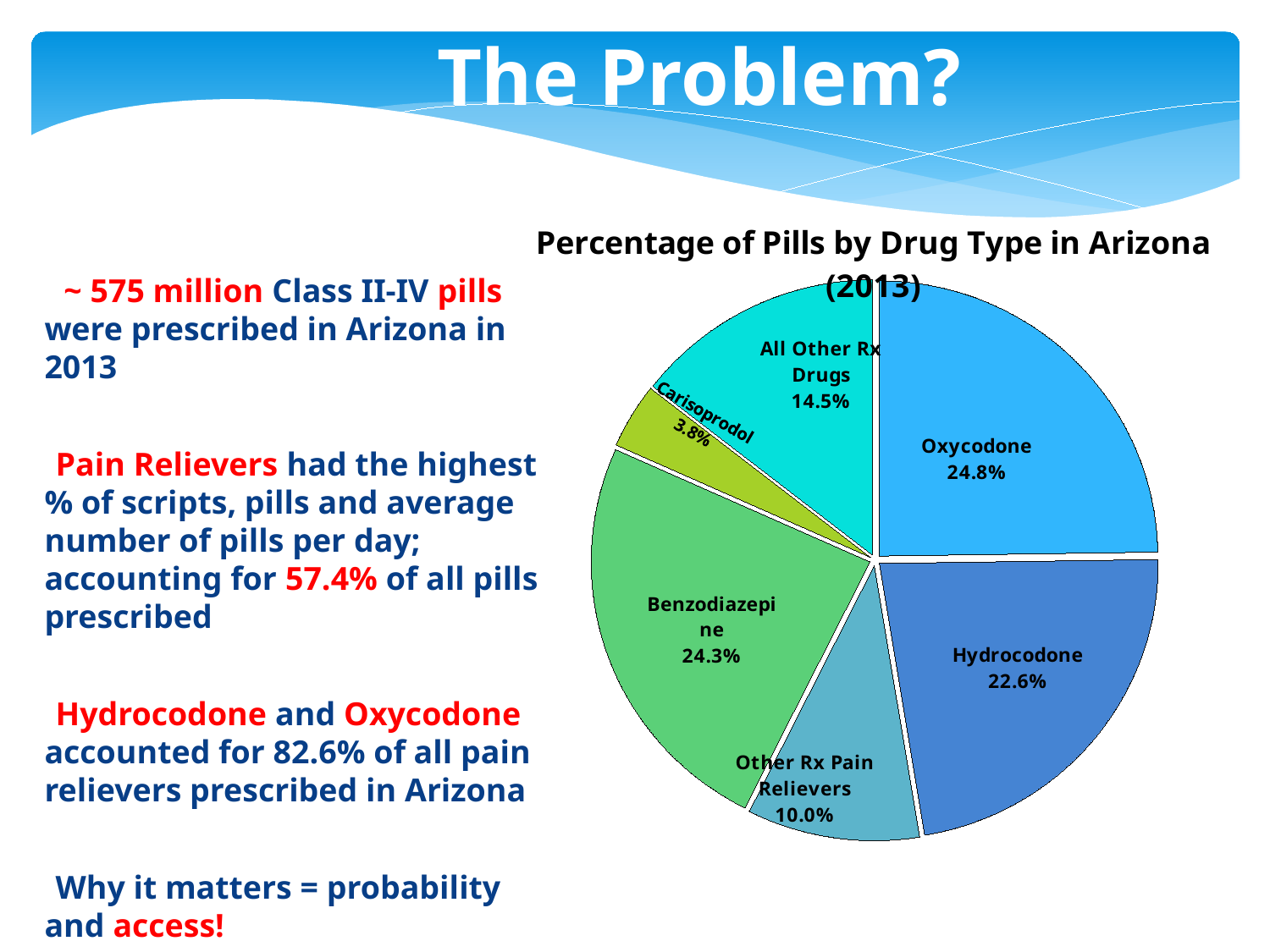
What percentage of pills does Benzodiazepine account for? 24.3% What percentage of pills does Oxycodone account for? 24.8% Which drug type has the smallest slice of the pie? Carisoprodol Which is larger, the share for Other Rx Pain Relievers or the share for All Other Rx Drugs? All Other Rx Drugs What is the share of the All Other Rx Drugs slice? 14.5% Which drug type has the largest slice of the pie? Oxycodone What is the difference in percentage points between Oxycodone and Hydrocodone? 2.2% What percentage of pills does Carisoprodol account for? 3.8% What type of chart is shown on the slide? pie chart What percentage of pills does Hydrocodone account for? 22.6% What is the title of the chart? Percentage of Pills by Drug Type in Arizona (2013) How many drug types (slices) are shown in the pie chart? 6